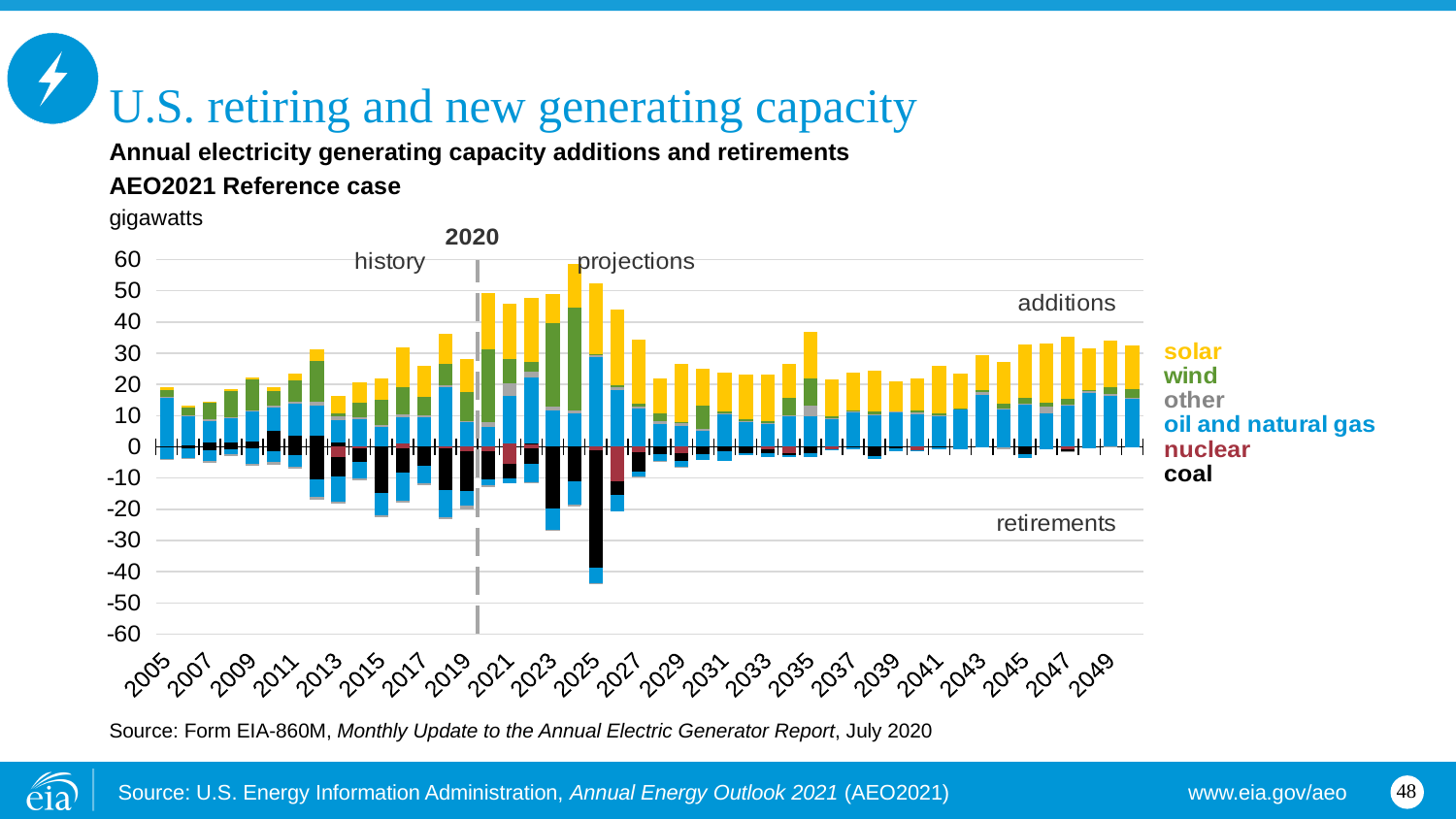
How many series does the legend list? 6 Is the total additions value for 2006 greater or less than 20 gigawatts? less What unit is the y axis measured in? gigawatts Is the total additions value for 2035 greater or less than 30 gigawatts? greater Is the total retirements value for 2025 greater or less than -40 gigawatts? less Which year has larger total additions, 2024 or 2021? 2024 Which year has the largest total capacity retirements? 2025 Do total additions generally rise or fall from 2040 to 2049? rise Which year does the dashed vertical line separating history from projections mark? 2020 Which year has the highest total capacity additions? 2024 What kind of chart is shown on the slide? stacked bar chart